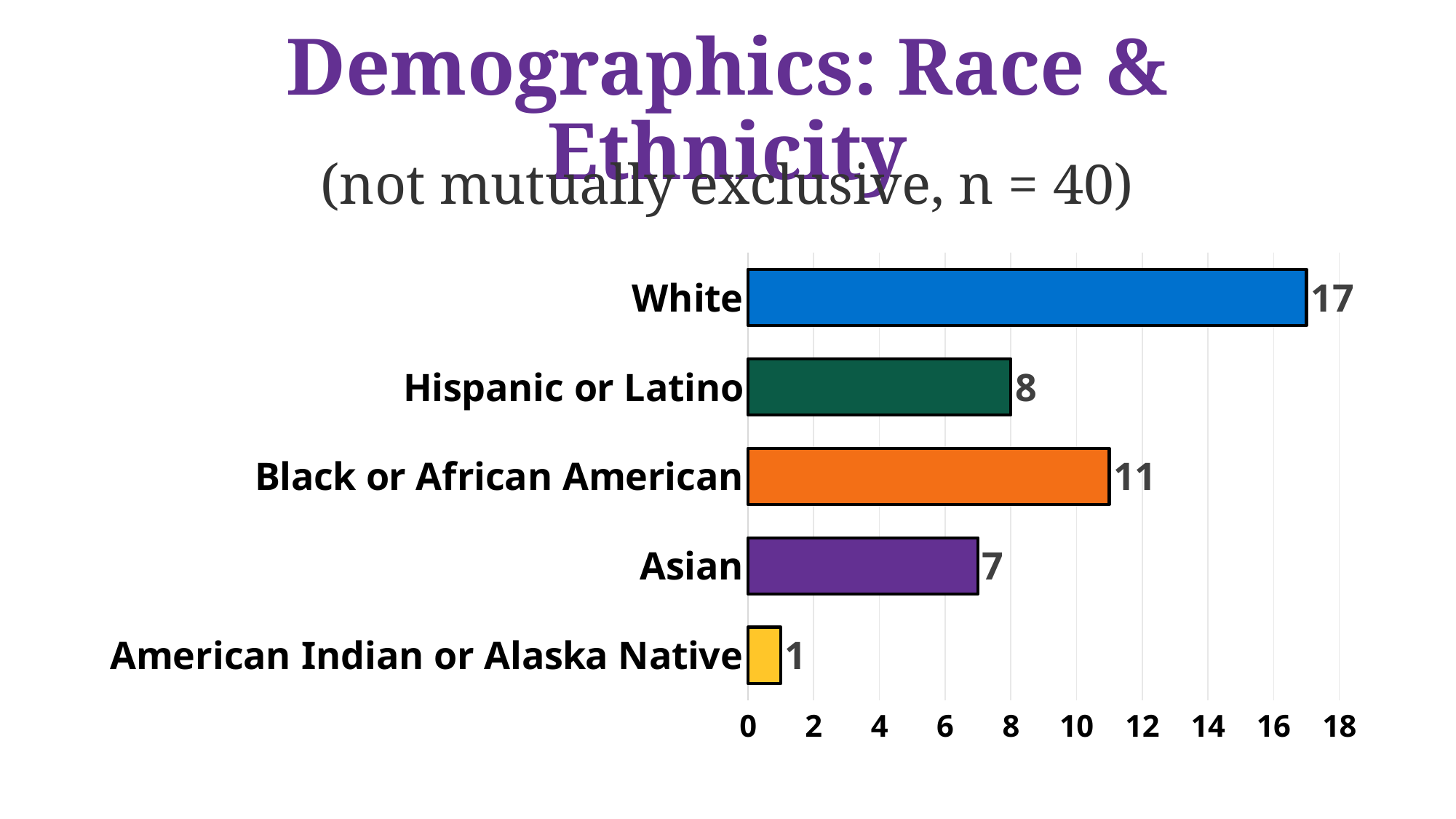
What kind of chart is shown on the slide? bar chart What is the value for Asian? 7 What is the value for American Indian or Alaska Native? 1 What is the value for Hispanic or Latino? 8 How many categories are shown in the chart? 5 Is the value for Black or African American greater or less than 10? greater What is the value for White? 17 What is the difference between the values for White and Black or African American? 6 Which category has the lowest value? American Indian or Alaska Native Which is larger, the value for Hispanic or Latino or the value for Asian? Hispanic or Latino Which category has the highest value? White What is the value for Black or African American? 11